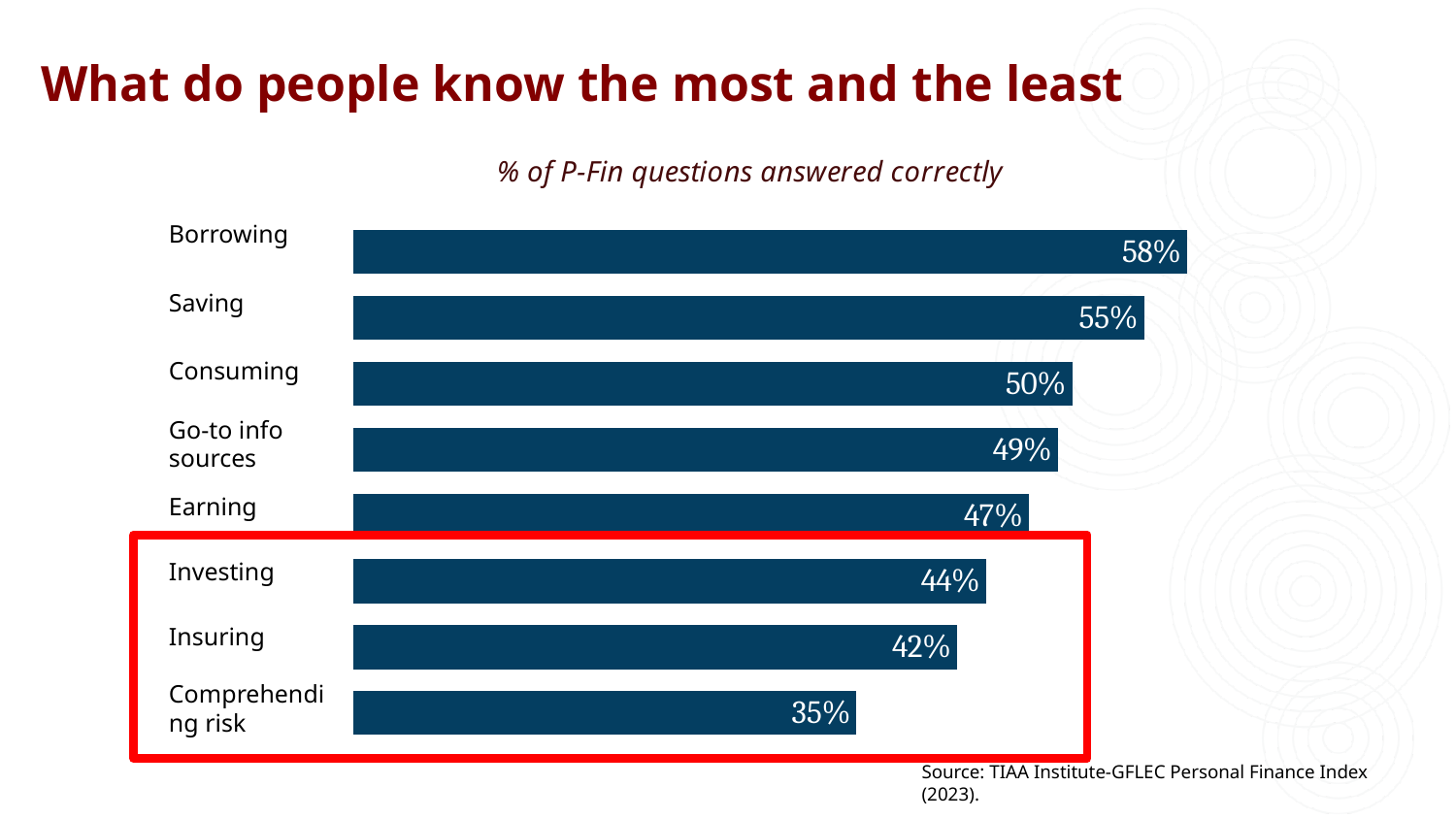
What is the difference between the values for Saving and Investing? 11% What kind of chart is shown on the slide? Bar chart Which three categories are enclosed by the red box on the slide? Investing, Insuring, Comprehending risk What is the value shown for Go-to info sources? 49% Which is larger, the value for Insuring or the value for Earning? Earning What is the value shown for Comprehending risk? 35% Which category has the lowest percentage of questions answered correctly? Comprehending risk What percentage of P-Fin questions about Borrowing were answered correctly? 58% What is the difference between the values for Borrowing and Comprehending risk? 23% What is the subtitle of the chart? % of P-Fin questions answered correctly Which category has the highest percentage of questions answered correctly? Borrowing How many categories are shown in the chart? 8